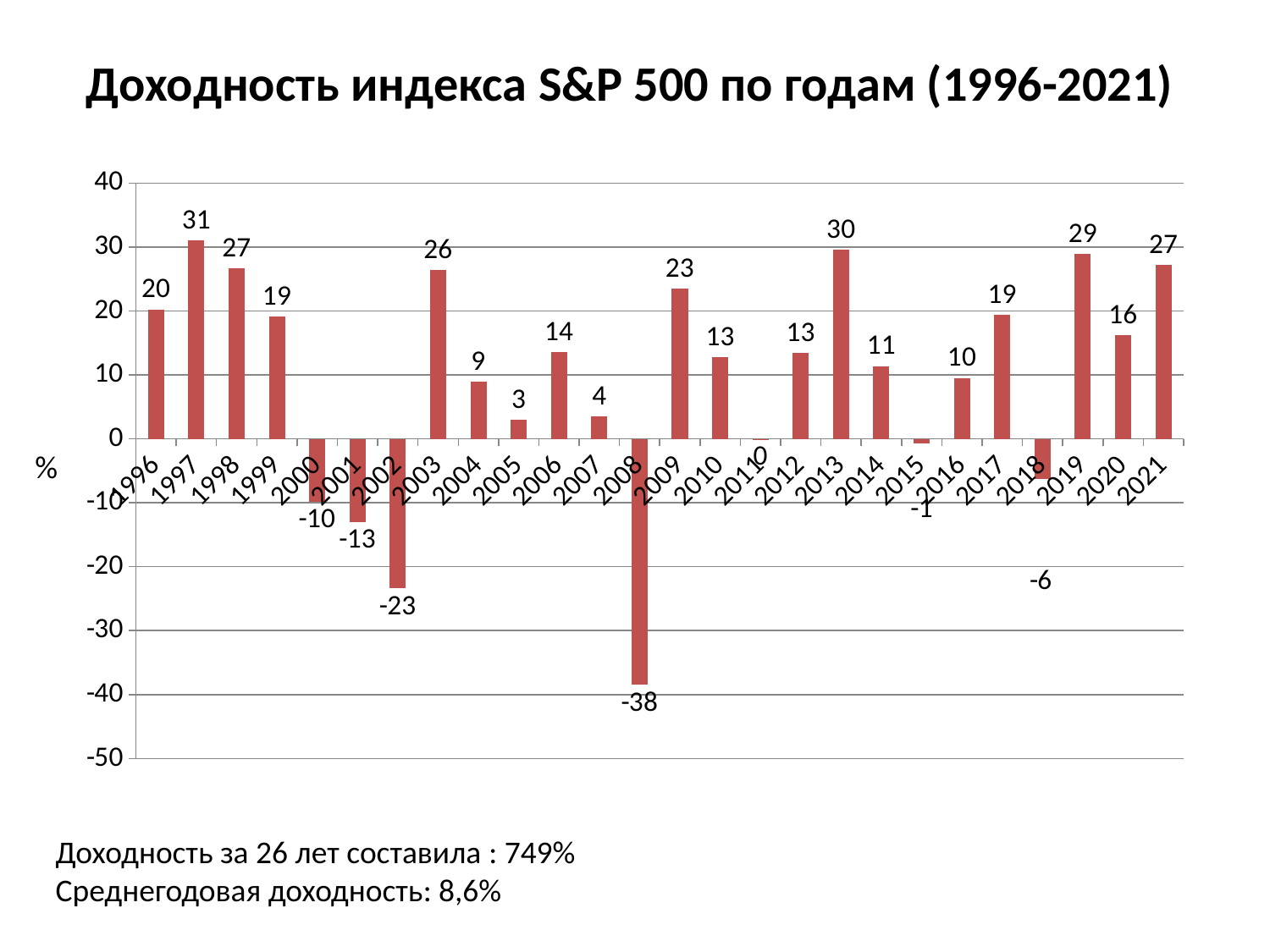
What is the S&P 500 return for 2008? -38 Do the returns rise or fall from 2000 to 2002? fall What is the S&P 500 return for 2021? 27 Which year has the larger return, 2019 or 2020? 2019 How many years are plotted on the chart? 26 What is the S&P 500 return for 2013? 30 What is the difference between the return for 1997 and the return for 1996? 11 What is the title of the chart? Доходность индекса S&P 500 по годам (1996-2021) What type of chart is shown on the slide? bar chart What is the S&P 500 return for 2002? -23 Which year has the lowest return on the chart? 2008 Which year has the highest return on the chart? 1997